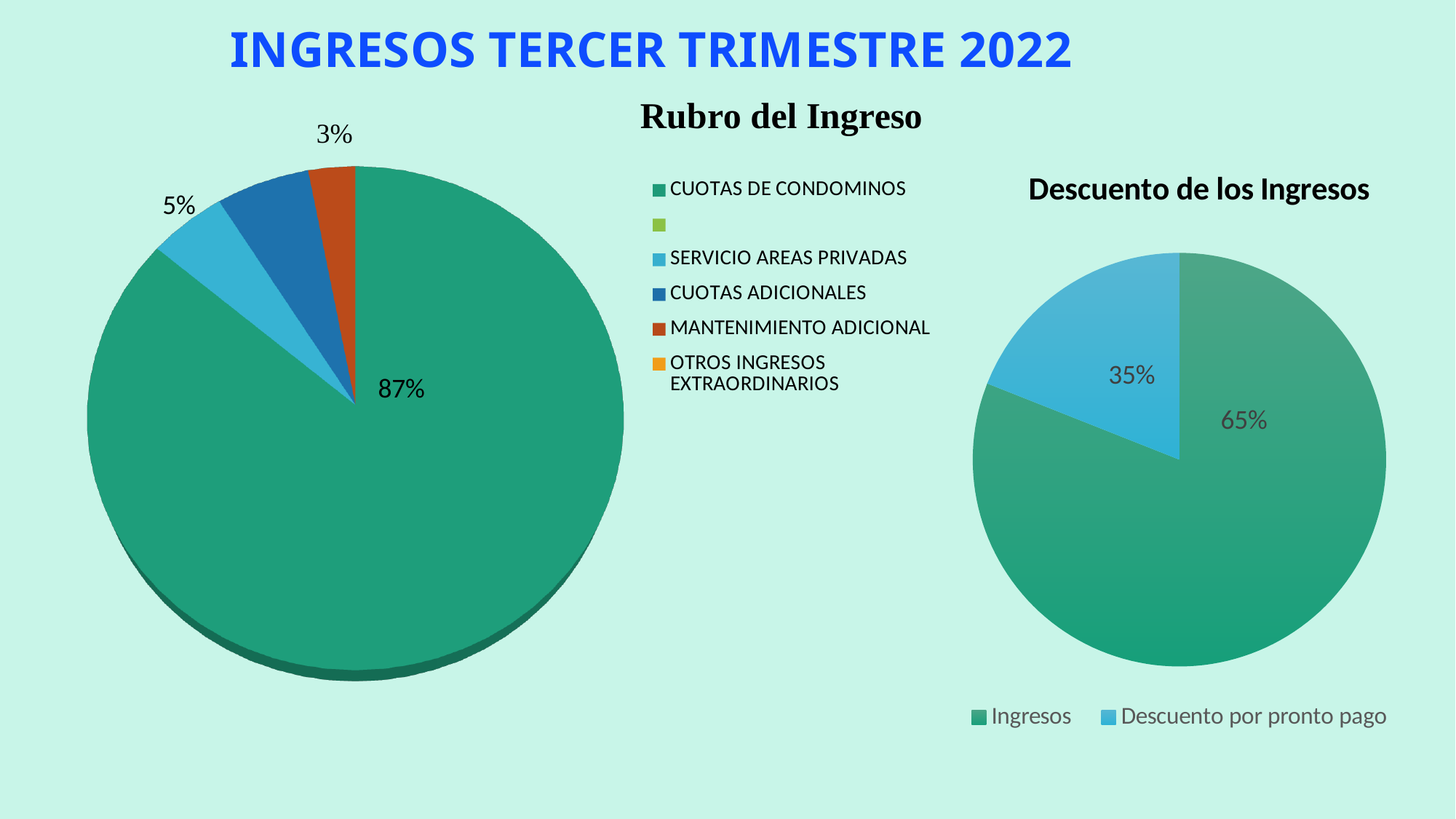
In the "Descuento de los Ingresos" chart, what is the difference in percentage points between Ingresos and Descuento por pronto pago? 30 percentage points What is the title of the pie chart on the right side of the slide? Descuento de los Ingresos In the "Descuento de los Ingresos" chart, what share does Ingresos have? 65% How many entries does the legend of the "Descuento de los Ingresos" chart list? 2 What kind of chart is the "Rubro del Ingreso" chart on the left? Pie chart In the "Rubro del Ingreso" chart, which category has the largest slice? CUOTAS DE CONDOMINOS In the "Rubro del Ingreso" chart, which is larger: SERVICIO AREAS PRIVADAS or MANTENIMIENTO ADICIONAL? SERVICIO AREAS PRIVADAS In the "Descuento de los Ingresos" chart, what share does Descuento por pronto pago have? 35% In the "Rubro del Ingreso" chart, what share does MANTENIMIENTO ADICIONAL have? 3% In the "Rubro del Ingreso" chart, what is the difference in percentage points between CUOTAS DE CONDOMINOS and SERVICIO AREAS PRIVADAS? 82 percentage points